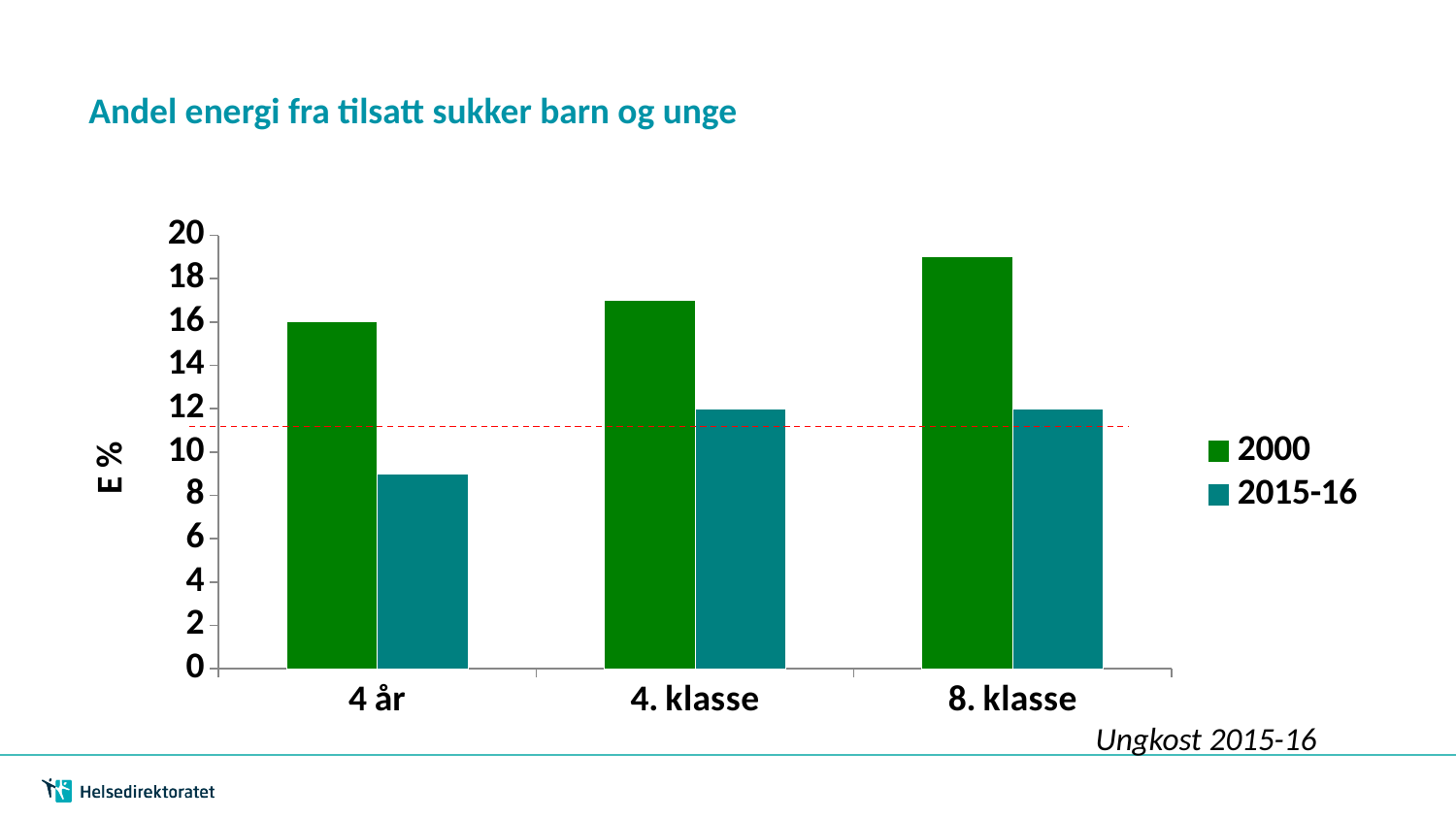
For 4 år, which series has the larger value, 2000 or 2015-16? 2000 For 8. klasse, which series has the larger value, 2000 or 2015-16? 2000 Do the values for the 2000 series rise or fall from 4 år to 8. klasse? rise Which category has the lowest value for the 2015-16 series? 4 år Is the value for 4 år in the 2015-16 series greater or less than 10? less What kind of chart is shown on the slide? bar chart Which category has the highest value for the 2000 series? 8. klasse How many series does the legend list? 2 What is the label on the y axis? E % How many categories are shown on the x axis? 3 Is the value for 8. klasse in the 2000 series greater or less than 18? greater